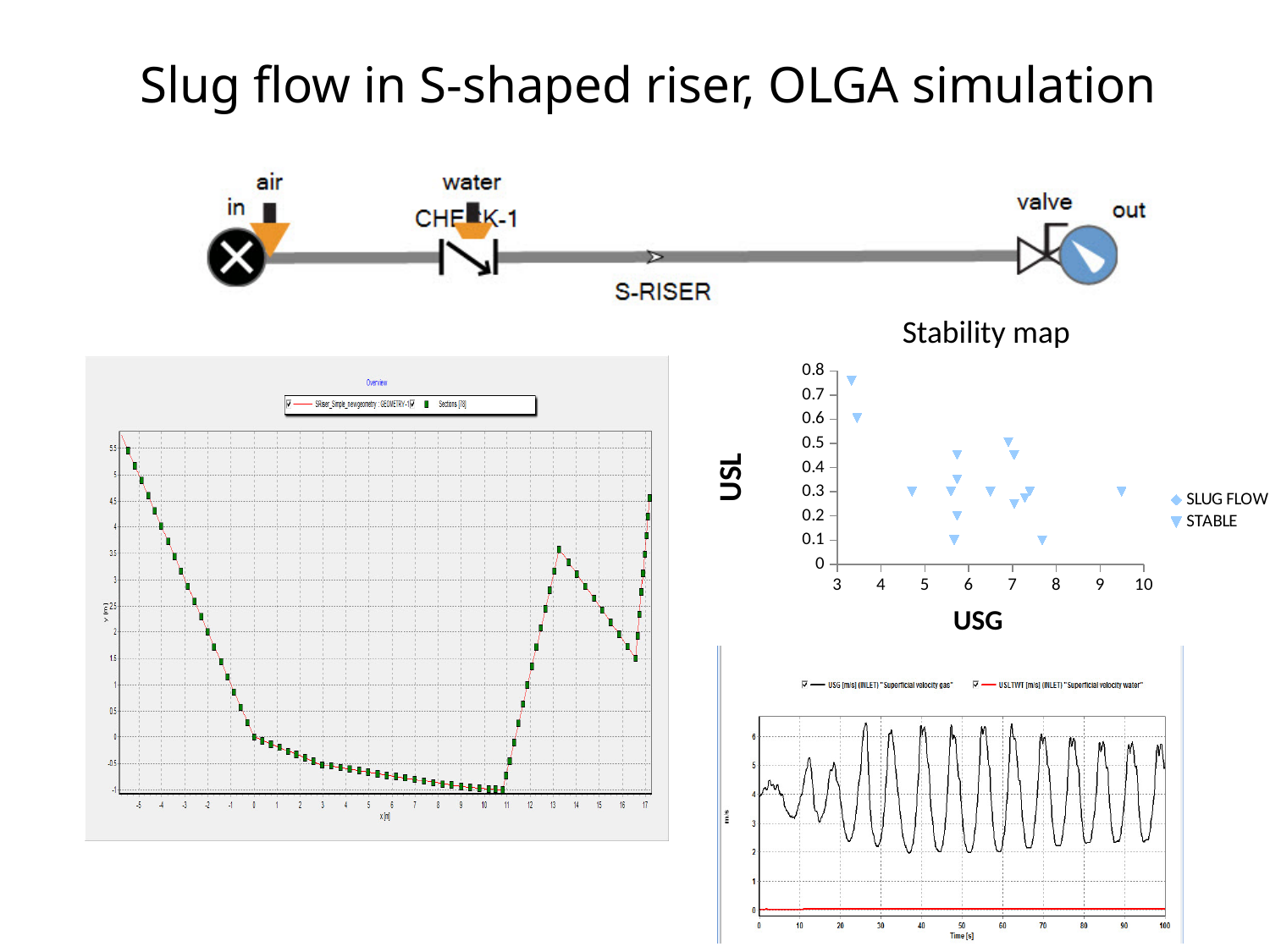
In the Stability map, which series do the plotted points belong to, SLUG FLOW or STABLE? STABLE In the bottom-right chart, which series has the larger values, the superficial velocity gas (USG) or the superficial velocity water (USLTWT)? USG (superficial velocity gas) What kind of chart is the bottom-right chart with Time [s] on the x axis? line chart What is the label of the horizontal axis of the Stability map? USG In the Stability map, is the highest USL value plotted greater or less than 0.7? greater How many series does the legend of the Stability map list? 2 What is the maximum value shown on the USL axis of the Stability map? 0.8 What are the two series named in the legend of the Stability map? SLUG FLOW and STABLE What kind of chart is the Stability map? scatter chart In the Stability map, is the USL value of the point at USG of about 9.5 greater or less than 0.4? less In the Stability map, is the lowest USL value plotted greater or less than 0.2? less What is the maximum value shown on the USG axis of the Stability map? 10